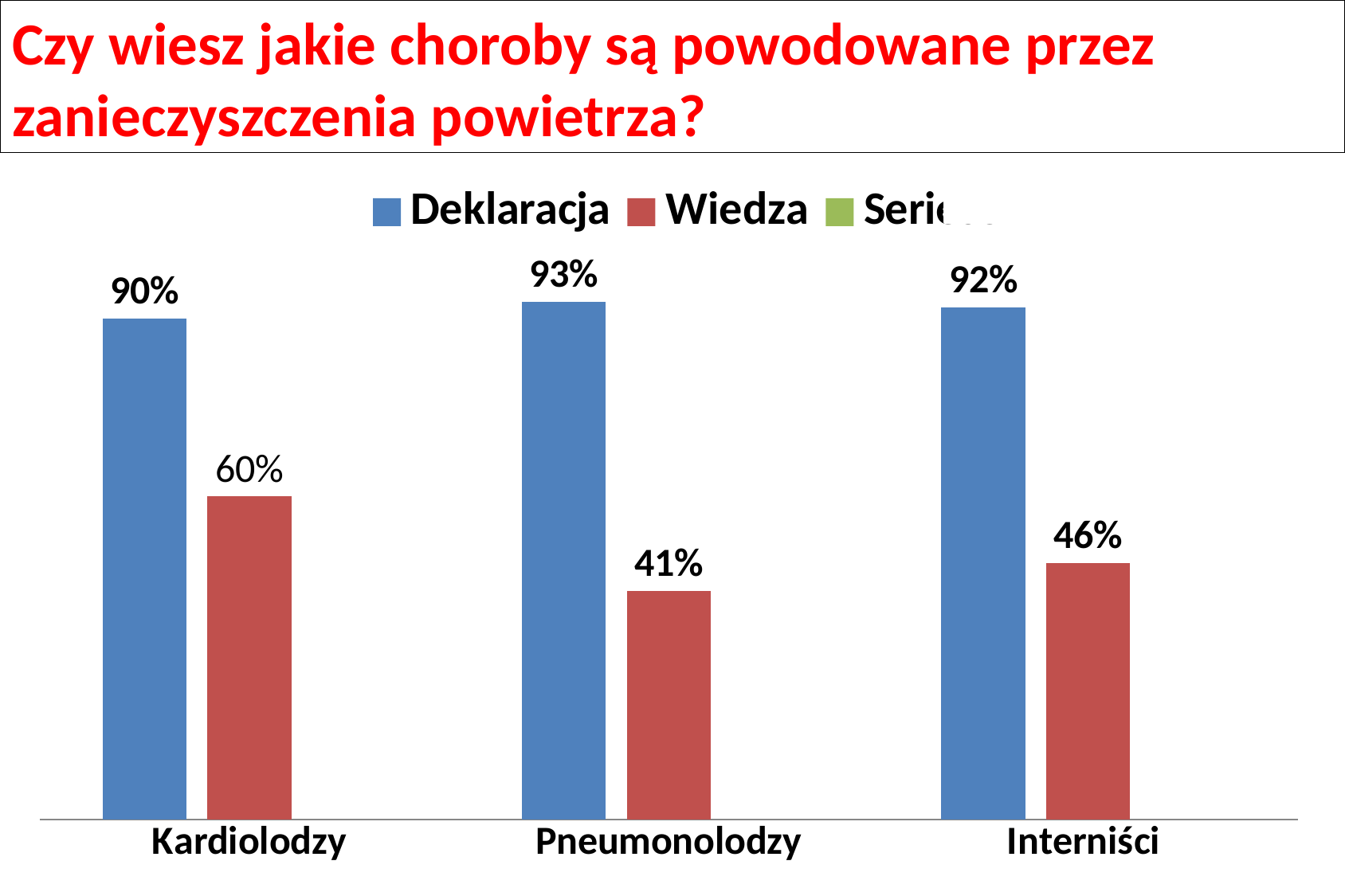
What is the difference between the Deklaracja and Wiedza values for Interniści? 46% What is the Deklaracja value for Kardiolodzy? 90% What is the Wiedza value for Interniści? 46% What is the difference between the Deklaracja and Wiedza values for Kardiolodzy? 30% What kind of chart is shown on the slide? bar chart What is the Deklaracja value for Pneumonolodzy? 93% How many categories are shown on the x axis? 3 Which is larger, the Wiedza value for Interniści or for Pneumonolodzy? Interniści What is the Wiedza value for Pneumonolodzy? 41% Which category has the lowest Wiedza value? Pneumonolodzy Which category has the highest Deklaracja value? Pneumonolodzy Which category has the highest Wiedza value? Kardiolodzy